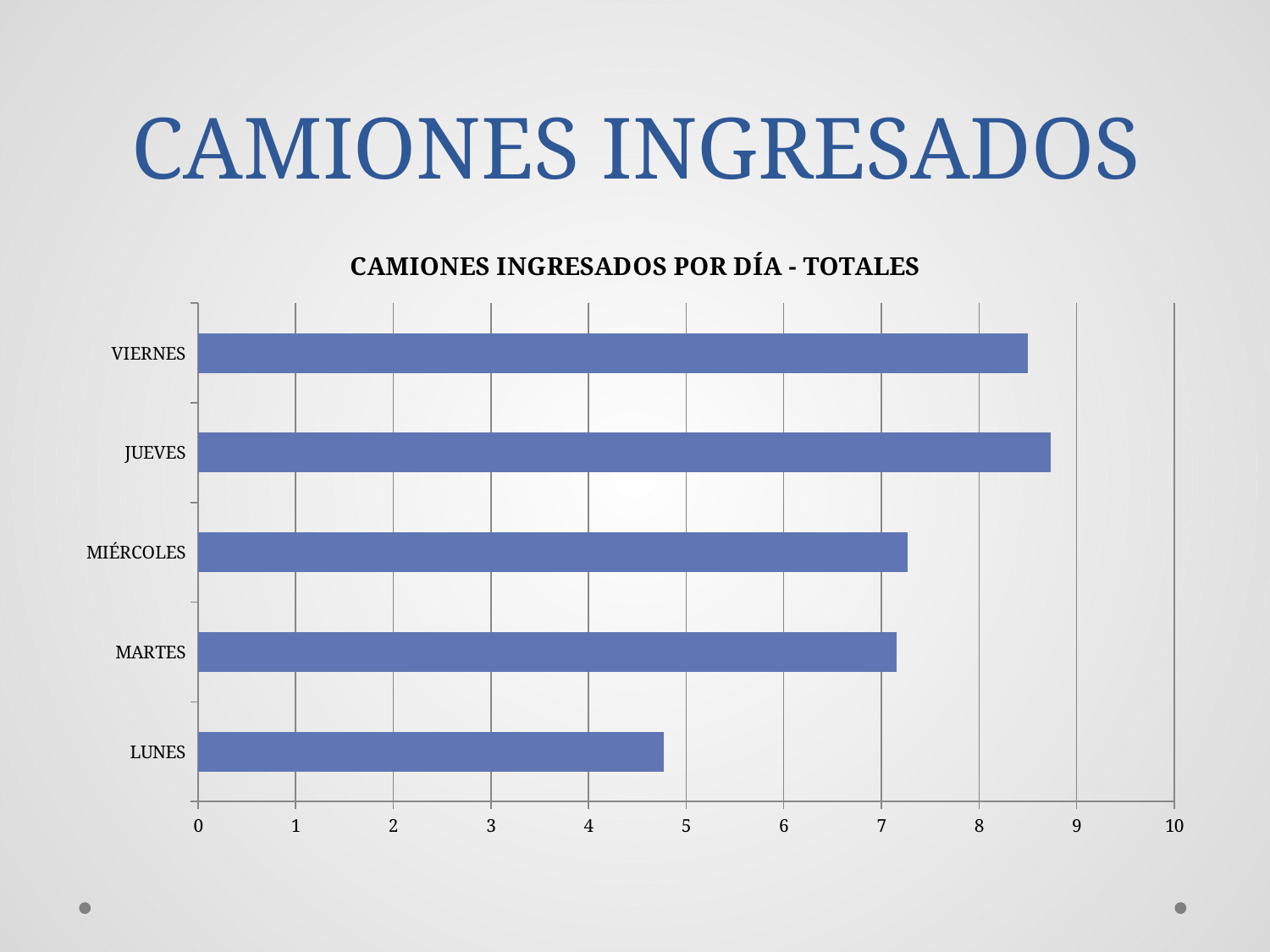
Is the value for MIÉRCOLES greater or less than 8? less What is the title of the chart? CAMIONES INGRESADOS POR DÍA - TOTALES How many days (categories) are plotted in the chart? 5 Which is larger, the value for JUEVES or the value for MIÉRCOLES? JUEVES What kind of chart is shown on the slide? bar chart Is the value for LUNES greater or less than 5? less Which day has the lowest value in the chart? LUNES Is the value for VIERNES greater or less than 8? greater What is the maximum value shown on the horizontal axis? 10 Which is larger, the value for LUNES or the value for MARTES? MARTES